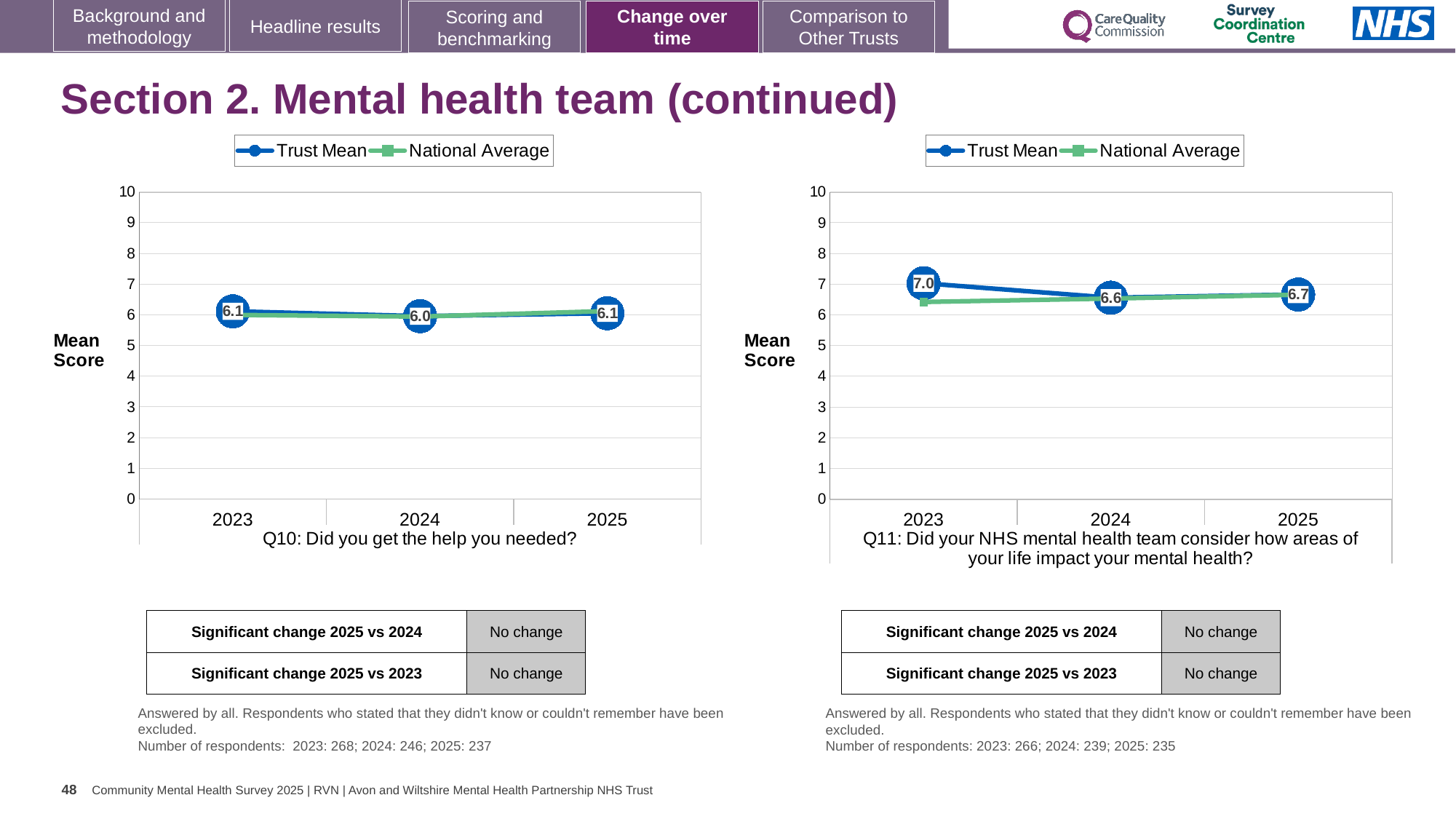
In the Q11 chart, what is the Trust Mean for 2023? 7.0 In the Q11 chart, which year has the highest Trust Mean? 2023 How many series does the legend of the Q11 chart list? 2 What kind of chart is the Q10 chart? Line chart In the Q11 chart, what is the difference between the Trust Mean for 2023 and 2024? 0.4 In the Q11 chart, is the Trust Mean larger in 2023 or in 2024? 2023 In the Q10 chart, is the National Average for 2025 greater or less than 5? greater In the Q10 chart, what is the Trust Mean for 2024? 6.0 In the Q11 chart, is the National Average for 2023 greater or less than 7? less In the Q11 chart, what is the Trust Mean for 2025? 6.7 In the Q10 chart, what is the Trust Mean for 2023? 6.1 How many years are plotted on the x axis of the Q10 chart? 3